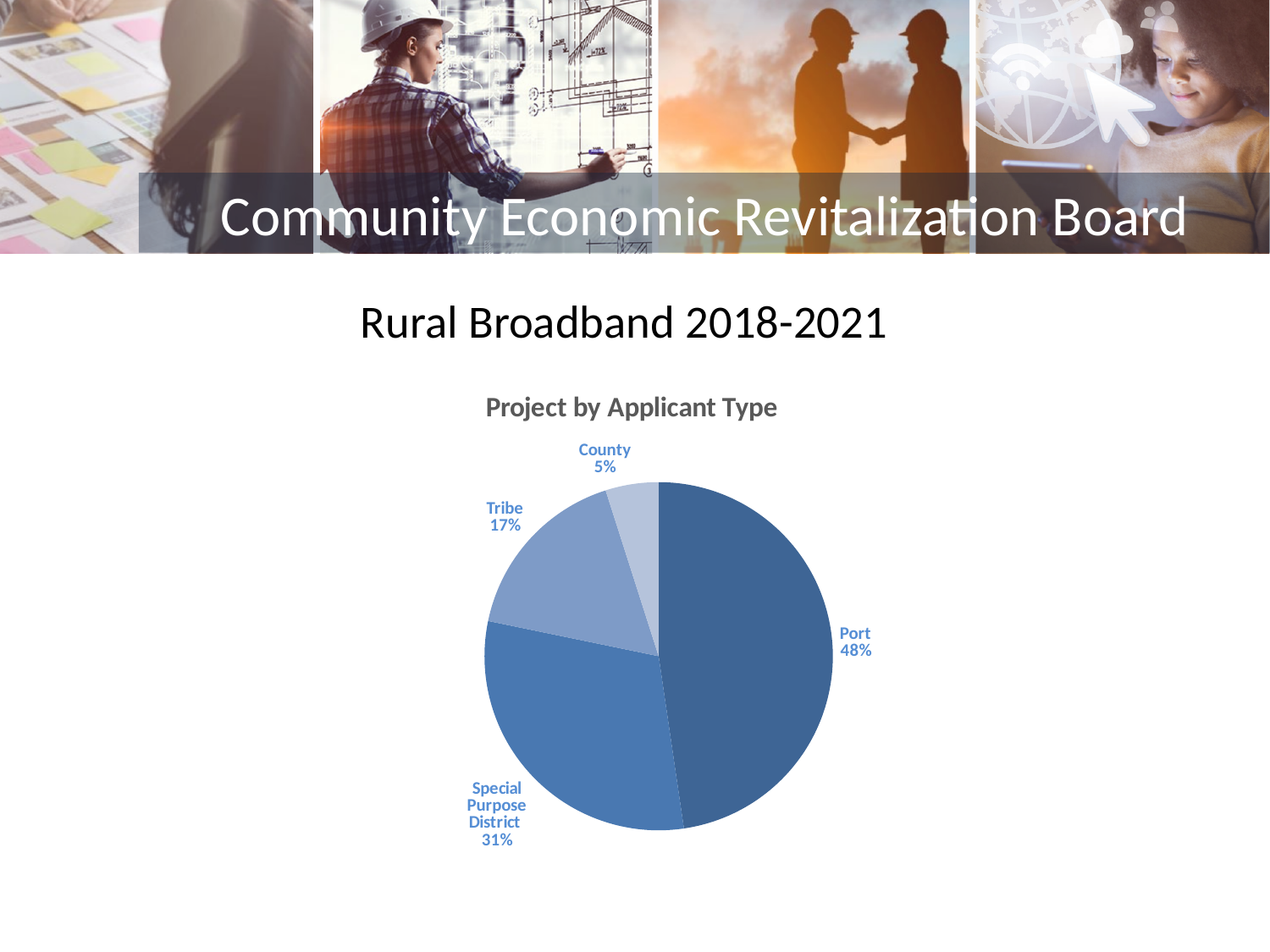
What share of projects is attributed to County? 5% What is the title of the chart? Project by Applicant Type What is the difference in percentage points between the Tribe share and the County share? 12 Which has a larger share of projects, Tribe or County? Tribe How many applicant types are shown in the pie chart? 4 Which applicant type has the smallest share of projects? County What type of chart is shown on the slide? Pie chart What share of projects is attributed to Port? 48% What share of projects is attributed to Tribe? 17% Which applicant type has the largest share of projects? Port What is the difference in percentage points between the Port share and the Special Purpose District share? 17